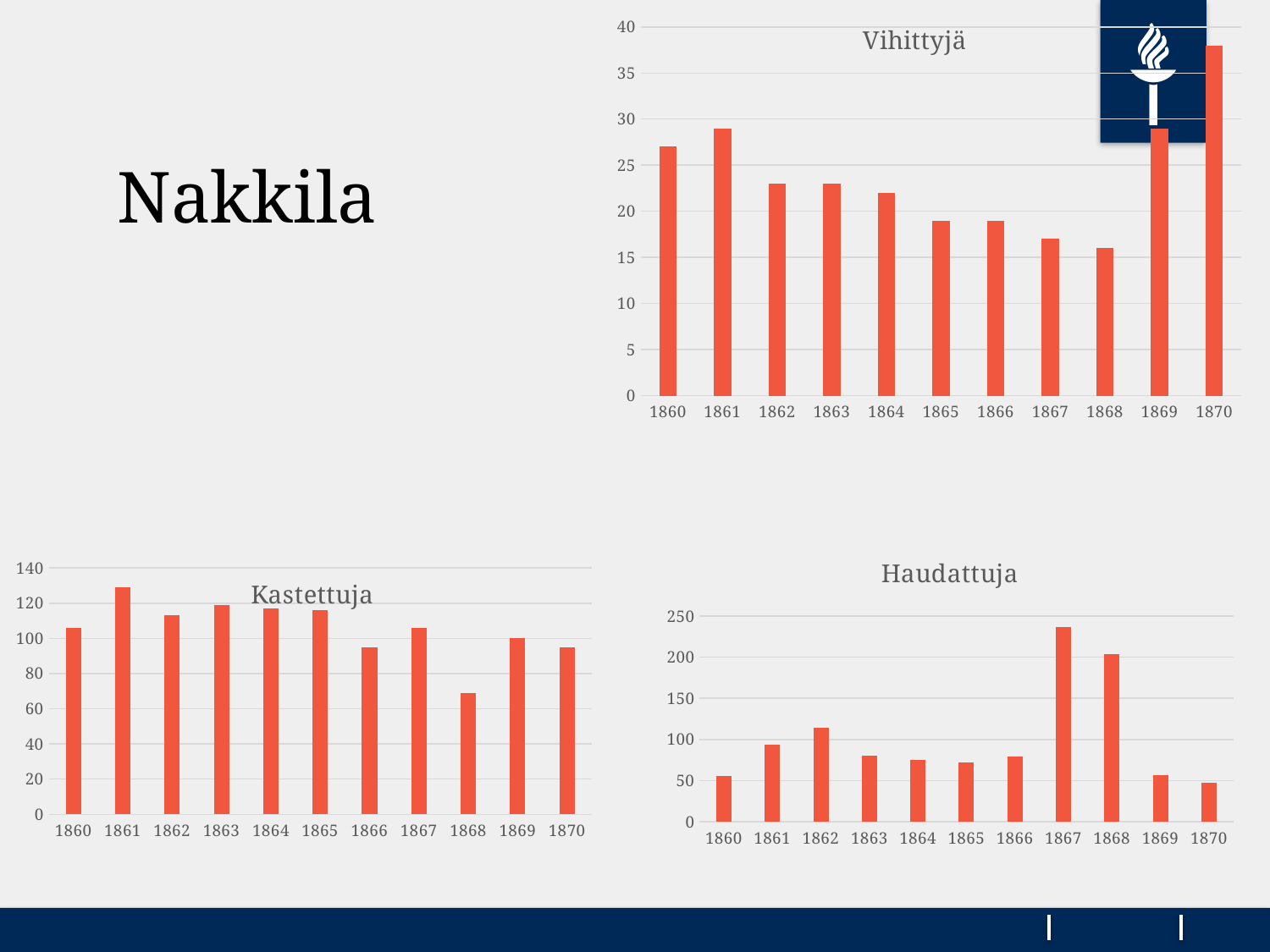
In the Kastettuja chart, is the value for 1868 greater or less than 80? less In the Haudattuja chart, which year has the highest value? 1867 How many years are shown on the x axis of the Kastettuja chart? 11 In the Vihittyjä chart, is the value for 1870 greater or less than 35? greater In the Kastettuja chart, which year has the lowest value? 1868 In the Haudattuja chart, is the value for 1868 greater or less than 150? greater In the Kastettuja chart, which year has the highest value? 1861 In the Vihittyjä chart, which year has the lowest value? 1868 In the Haudattuja chart, which is larger, the value for 1862 or the value for 1863? 1862 In the Vihittyjä chart, which year has the highest value? 1870 In the Haudattuja chart, which year has the lowest value? 1870